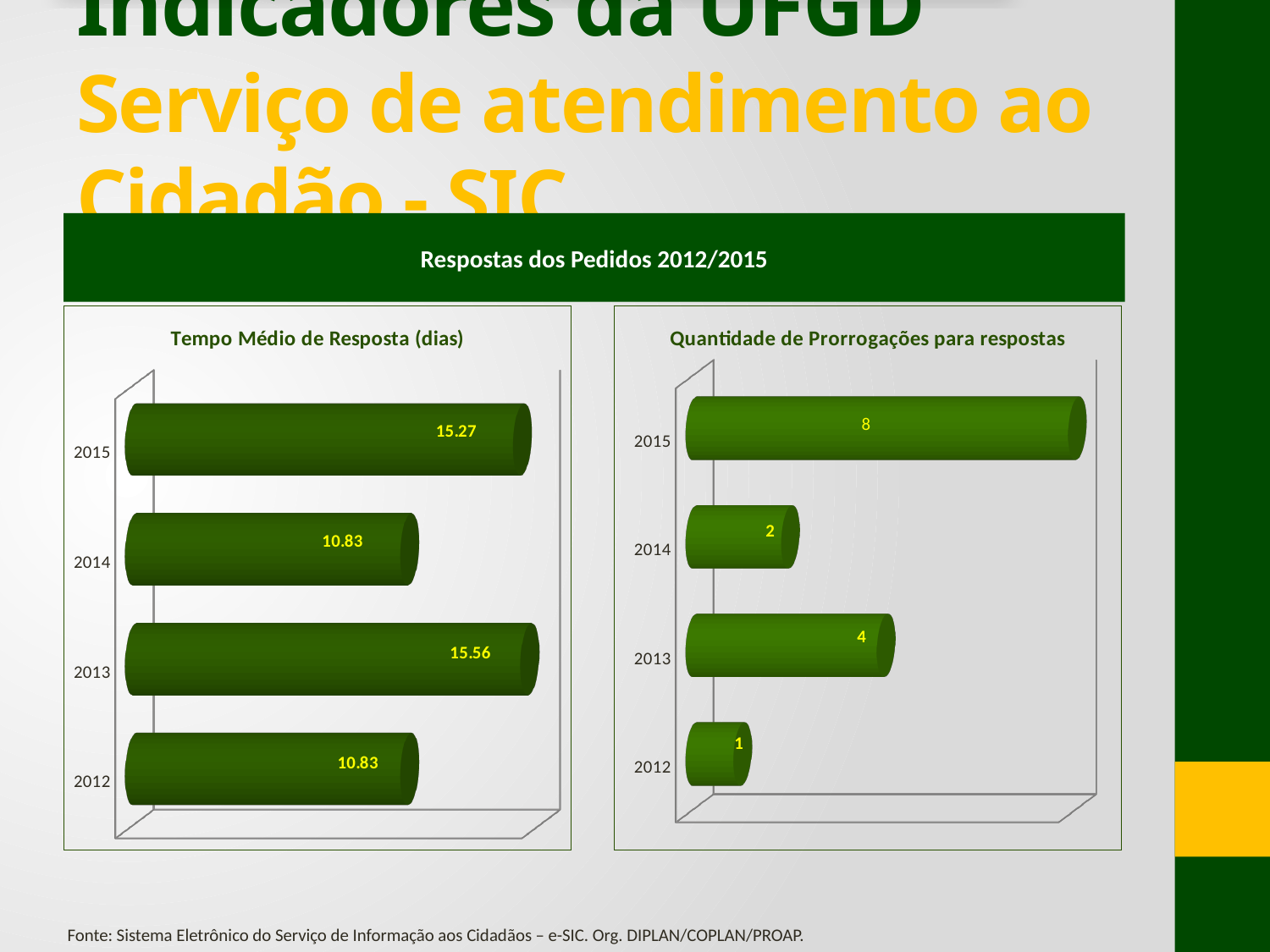
How many years are shown in the 'Tempo Médio de Resposta (dias)' chart? 4 In the 'Tempo Médio de Resposta (dias)' chart, what is the difference between the values for 2015 and 2014? 4.44 In the 'Quantidade de Prorrogações para respostas' chart, what is the difference between the values for 2015 and 2014? 6 In the 'Tempo Médio de Resposta (dias)' chart, what is the value for 2013? 15.56 In the 'Tempo Médio de Resposta (dias)' chart, what is the difference between the values for 2013 and 2015? 0.29 In the 'Tempo Médio de Resposta (dias)' chart, which year has the highest value? 2013 In the 'Tempo Médio de Resposta (dias)' chart, what is the value for 2015? 15.27 In the 'Quantidade de Prorrogações para respostas' chart, which is larger, the value for 2013 or the value for 2014? 2013 In the 'Quantidade de Prorrogações para respostas' chart, which year has the lowest value? 2012 In the 'Quantidade de Prorrogações para respostas' chart, which year has the highest value? 2015 In the 'Quantidade de Prorrogações para respostas' chart, what is the value for 2015? 8 In the 'Quantidade de Prorrogações para respostas' chart, what is the value for 2013? 4